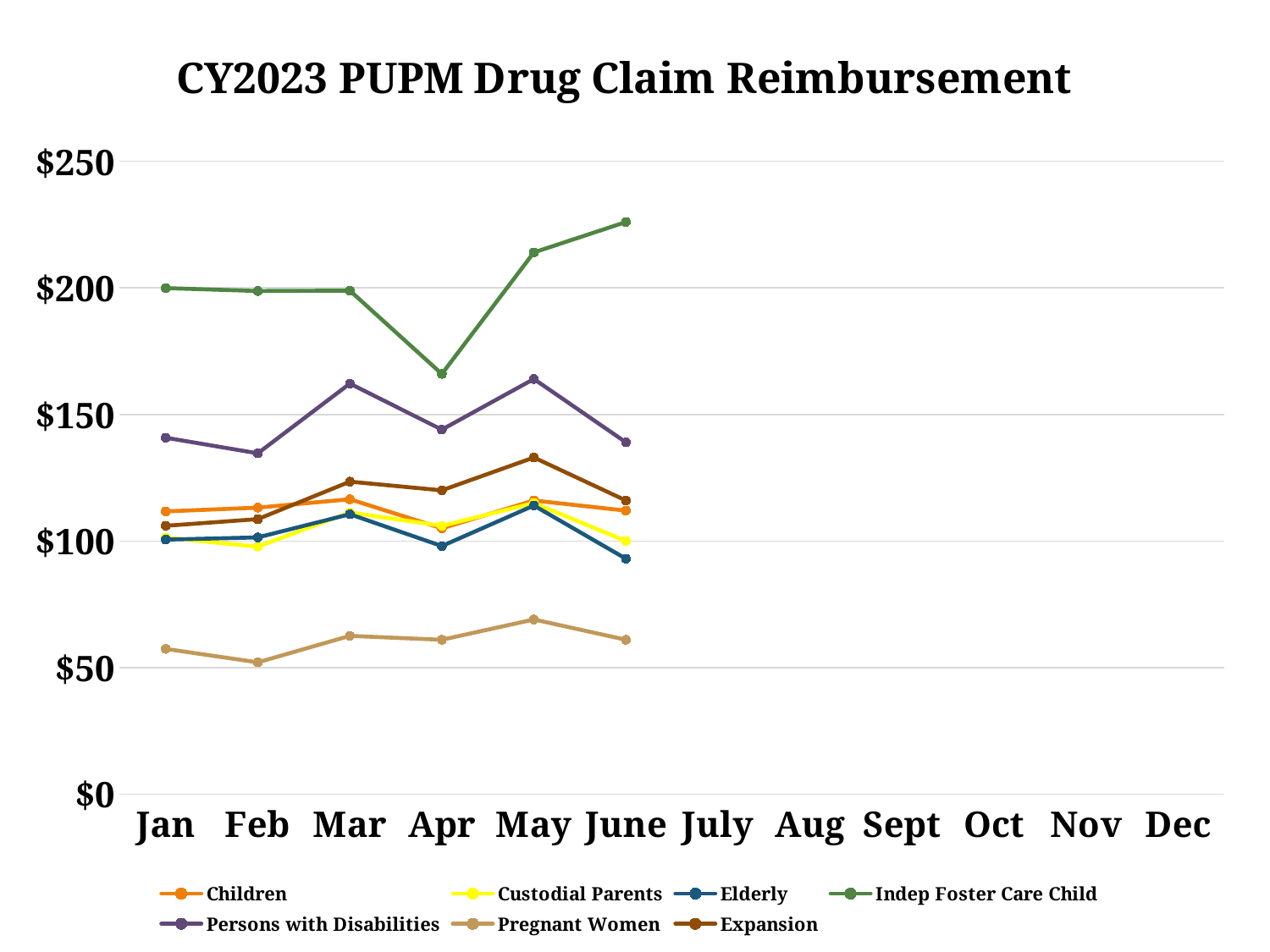
Is the value for Persons with Disabilities in Mar greater or less than $150? greater How many series does the legend list? 7 Is the value for Elderly in June greater or less than $100? less Is the value for Indep Foster Care Child in June greater or less than $200? greater Which series has the highest value in June? Indep Foster Care Child Which is larger in Apr: the value for Expansion or the value for Children? Expansion What is the title of the chart? CY2023 PUPM Drug Claim Reimbursement Which series has the lowest value in May? Pregnant Women Does the Indep Foster Care Child line rise or fall from Apr to June? rise How many months have plotted data points? 6 What kind of chart is shown on the slide? line chart